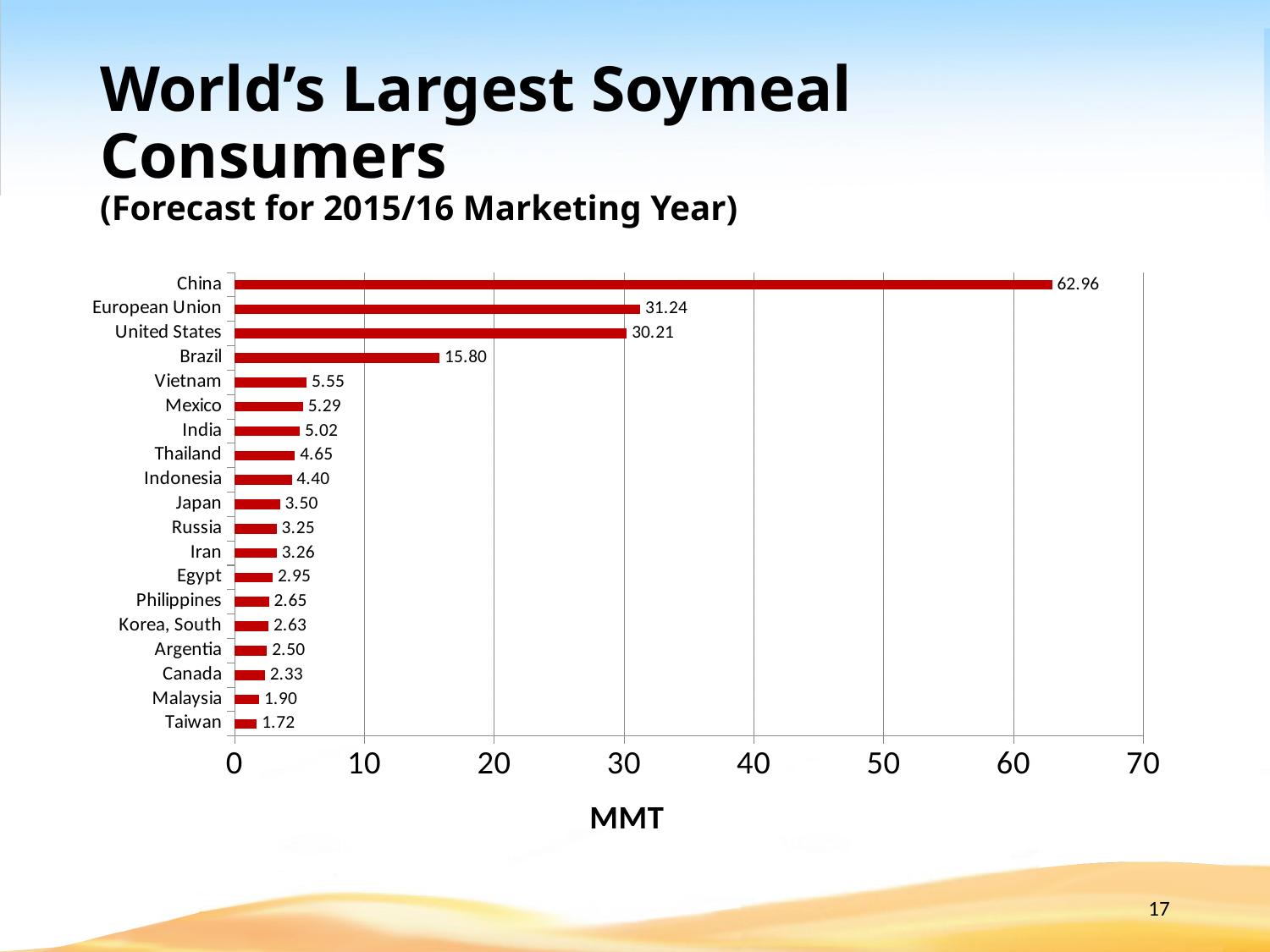
What is the difference between the values for the European Union and the United States? 1.03 Which country has the lowest value on the chart? Taiwan What is the value shown for Brazil? 15.80 What unit is labelled on the horizontal axis? MMT Which country or region has the highest soymeal consumption on the chart? China Is the value for the United States greater or less than 30? greater What is the forecast soymeal consumption for China? 62.96 What is the value shown for Indonesia? 4.40 What is the difference between the values for China and Brazil? 47.16 How many countries or regions are shown on the chart? 19 What kind of chart is shown on the slide? Bar chart Which has a larger value, Vietnam or Mexico? Vietnam